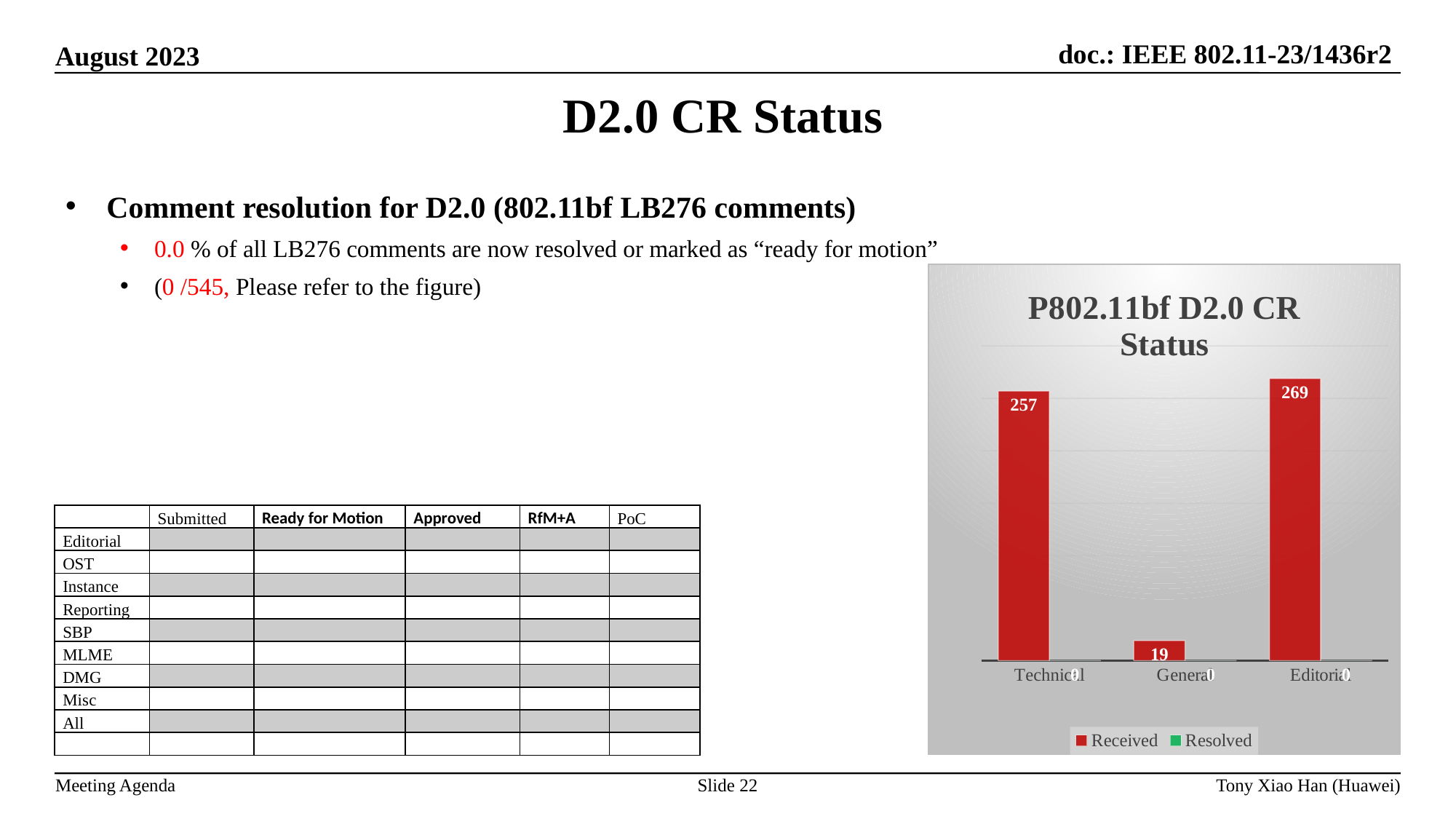
How many categories are shown on the x axis of the chart? 3 Which is larger, the Received value for Technical or for General? Technical How many series does the chart legend list? 2 What is the difference between the Received values for Editorial and Technical? 12 Which category has the lowest Received value? General Which category has the highest Received value? Editorial What is the title of the chart on the slide? P802.11bf D2.0 CR Status What is the Resolved value for Technical? 0 What is the Received value for Technical? 257 What is the Received value for Editorial? 269 What is the Received value for General? 19 What type of chart is shown on the slide? bar chart